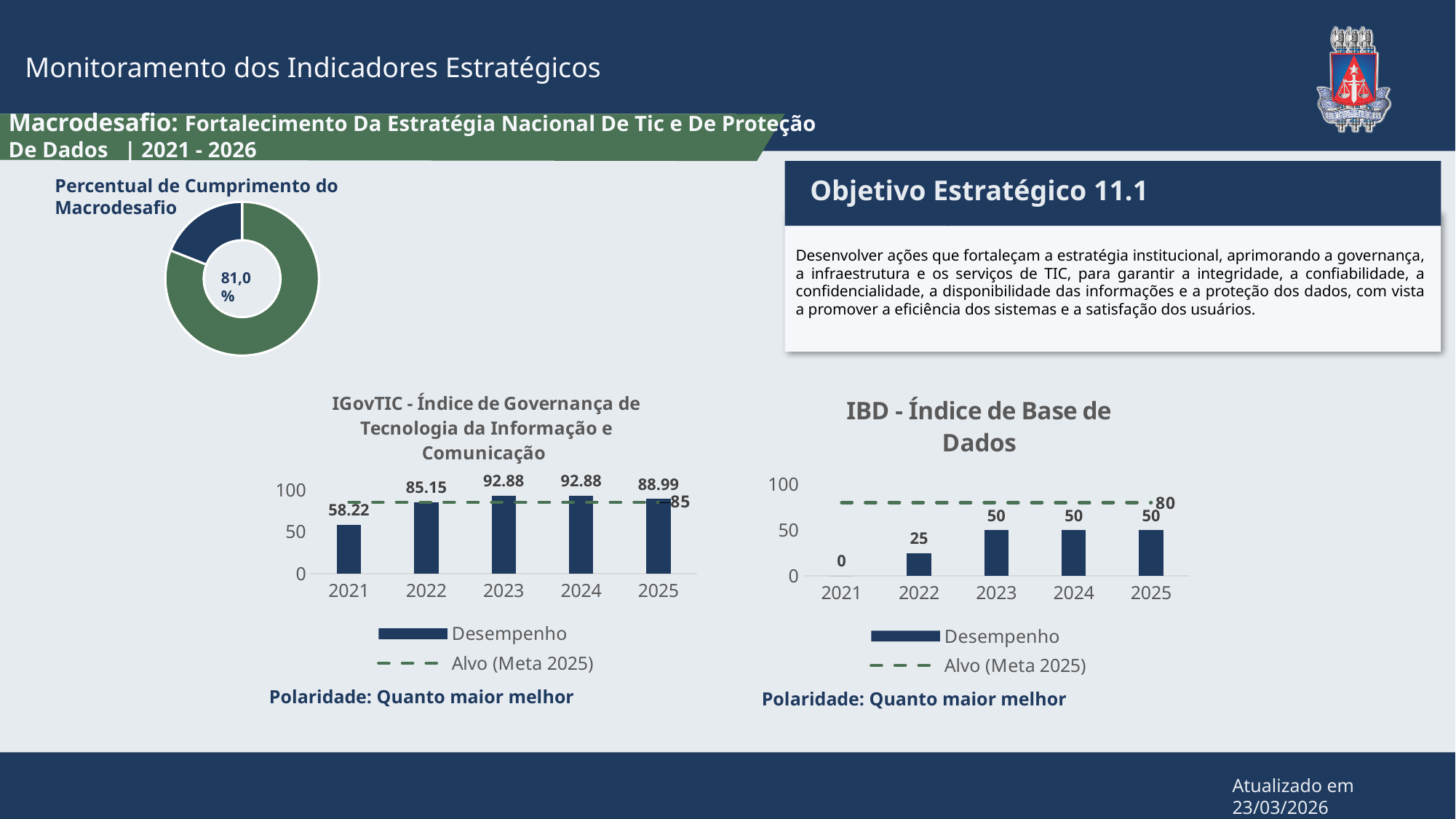
In the IGovTIC chart, is the Desempenho value for 2021 greater or less than the Alvo (Meta 2025) of 85? less In the IGovTIC chart, which year has the lowest Desempenho value? 2021 In the IGovTIC chart, what is the Desempenho value for 2021? 58.22 In the IBD - Índice de Base de Dados chart, how many years are shown on the x axis? 5 In the IGovTIC chart, what is the Desempenho value for 2025? 88.99 In the IGovTIC chart, what is the Alvo (Meta 2025) value? 85 In the IBD - Índice de Base de Dados chart, what is the difference between the Alvo (Meta 2025) and the Desempenho value for 2025? 30 In the IBD - Índice de Base de Dados chart, what is the Alvo (Meta 2025) value? 80 In the IGovTIC chart, what is the difference between the Desempenho values for 2022 and 2021? 26.93 In the IBD - Índice de Base de Dados chart, how many series does the legend list? 2 In the IBD - Índice de Base de Dados chart, what is the Desempenho value for 2022? 25 What percentage is shown in the centre of the Percentual de Cumprimento do Macrodesafio donut chart? 81,0%